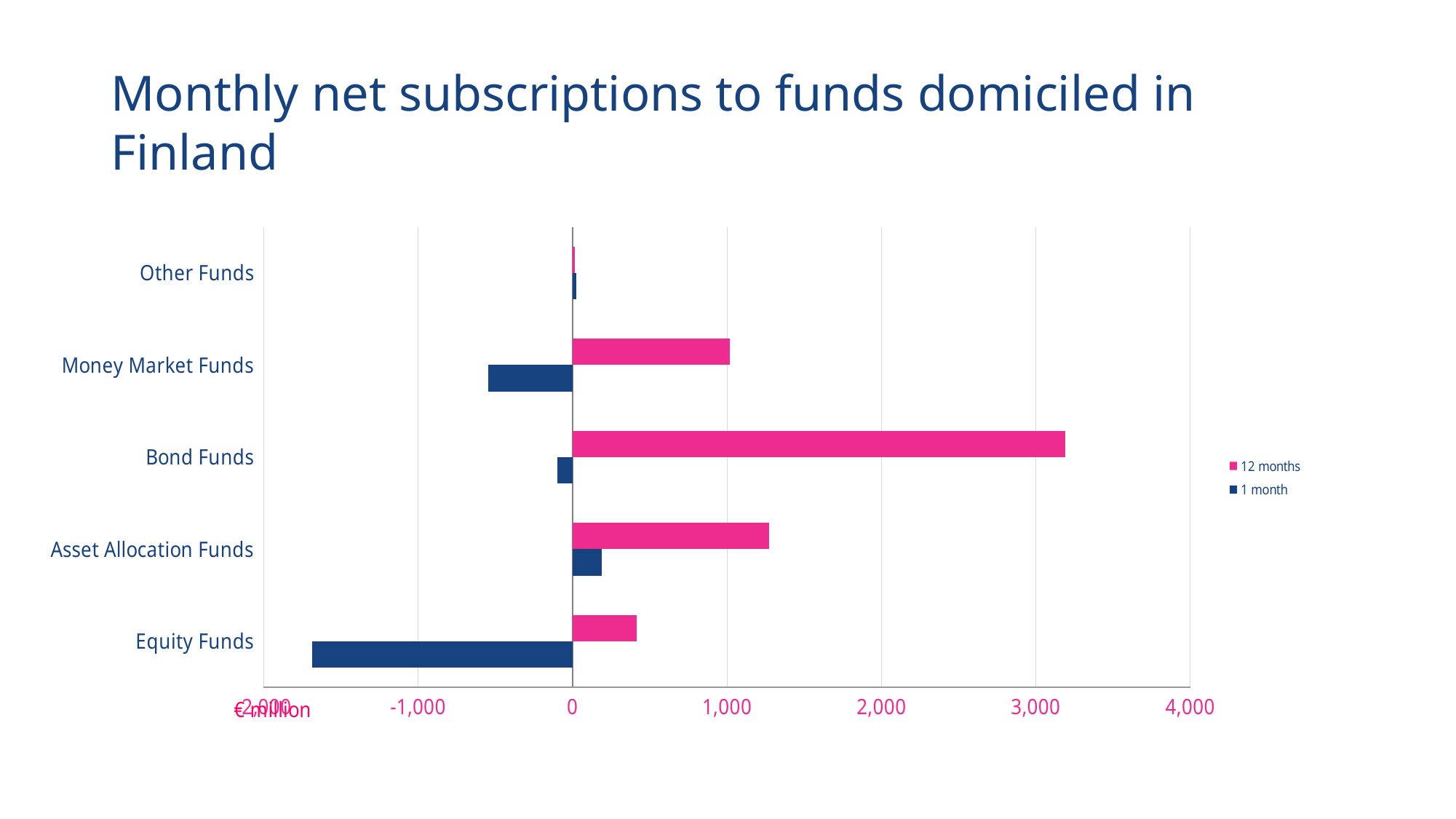
What kind of chart is shown on the slide? bar chart Which series is shown in pink in the legend? 12 months Is the 12 months value for Equity Funds greater or less than 1,000? less Which fund category has the lowest 1 month net subscriptions? Equity Funds What is the title of the chart? Monthly net subscriptions to funds domiciled in Finland Is the 12 months value for Asset Allocation Funds greater or less than 1,000? greater Is the 12 months value for Bond Funds greater or less than 3,000? greater How many fund categories are shown on the chart? 5 How many series does the legend list? 2 Which fund category has the highest 12 months net subscriptions? Bond Funds Which is larger, the 12 months value for Money Market Funds or the 12 months value for Equity Funds? Money Market Funds